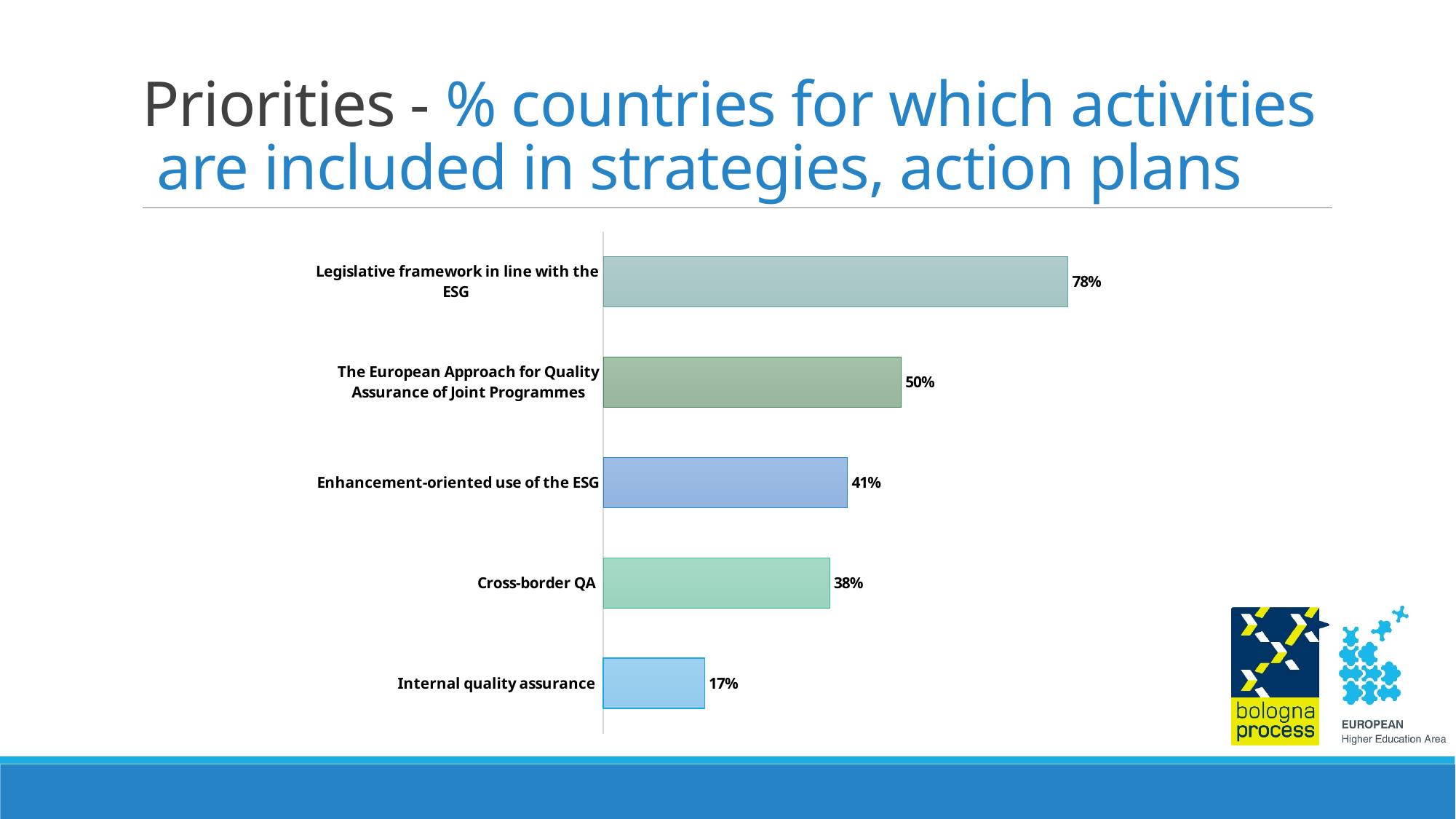
What is the value shown for 'Internal quality assurance'? 17% What is the difference between the values for 'Legislative framework in line with the ESG' and 'The European Approach for Quality Assurance of Joint Programmes'? 28% How many categories are shown in the chart? 5 Which category has the lowest value? Internal quality assurance What is the difference between the values for 'Cross-border QA' and 'Internal quality assurance'? 21% What is the value shown for 'The European Approach for Quality Assurance of Joint Programmes'? 50% What percentage of countries include 'Legislative framework in line with the ESG' in their strategies or action plans? 78% What is the value shown for 'Cross-border QA'? 38% What is the value shown for 'Enhancement-oriented use of the ESG'? 41% Which has a larger value: 'Enhancement-oriented use of the ESG' or 'Cross-border QA'? Enhancement-oriented use of the ESG What kind of chart is shown on the slide? Bar chart Which category has the highest value? Legislative framework in line with the ESG